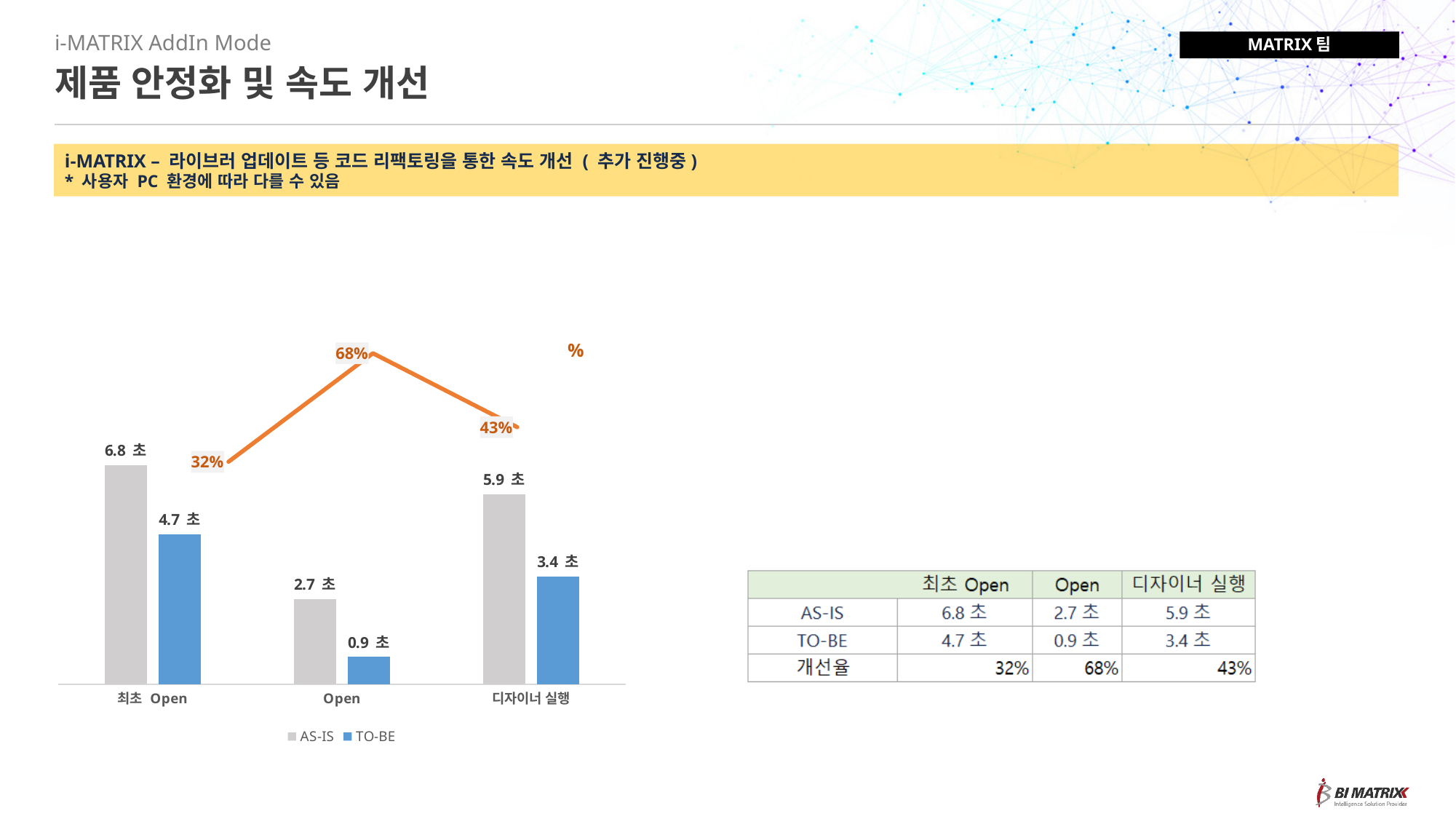
What is the TO-BE value for Open? 0.9 초 Which colour represents the TO-BE series in the chart? Blue How many series does the legend list? 2 Which category has the highest AS-IS value? 최초 Open What is the difference between the AS-IS and TO-BE values for 디자이너 실행? 2.5 초 What improvement percentage is shown on the orange line for Open? 68% What is the TO-BE value for 디자이너 실행? 3.4 초 Which category has the lowest TO-BE value? Open How many categories are shown on the x axis of the bar chart? 3 What kind of chart is used to show the AS-IS and TO-BE values? Bar chart What is the AS-IS value for 최초 Open? 6.8 초 Which is larger, the TO-BE value for 최초 Open or the TO-BE value for 디자이너 실행? 최초 Open